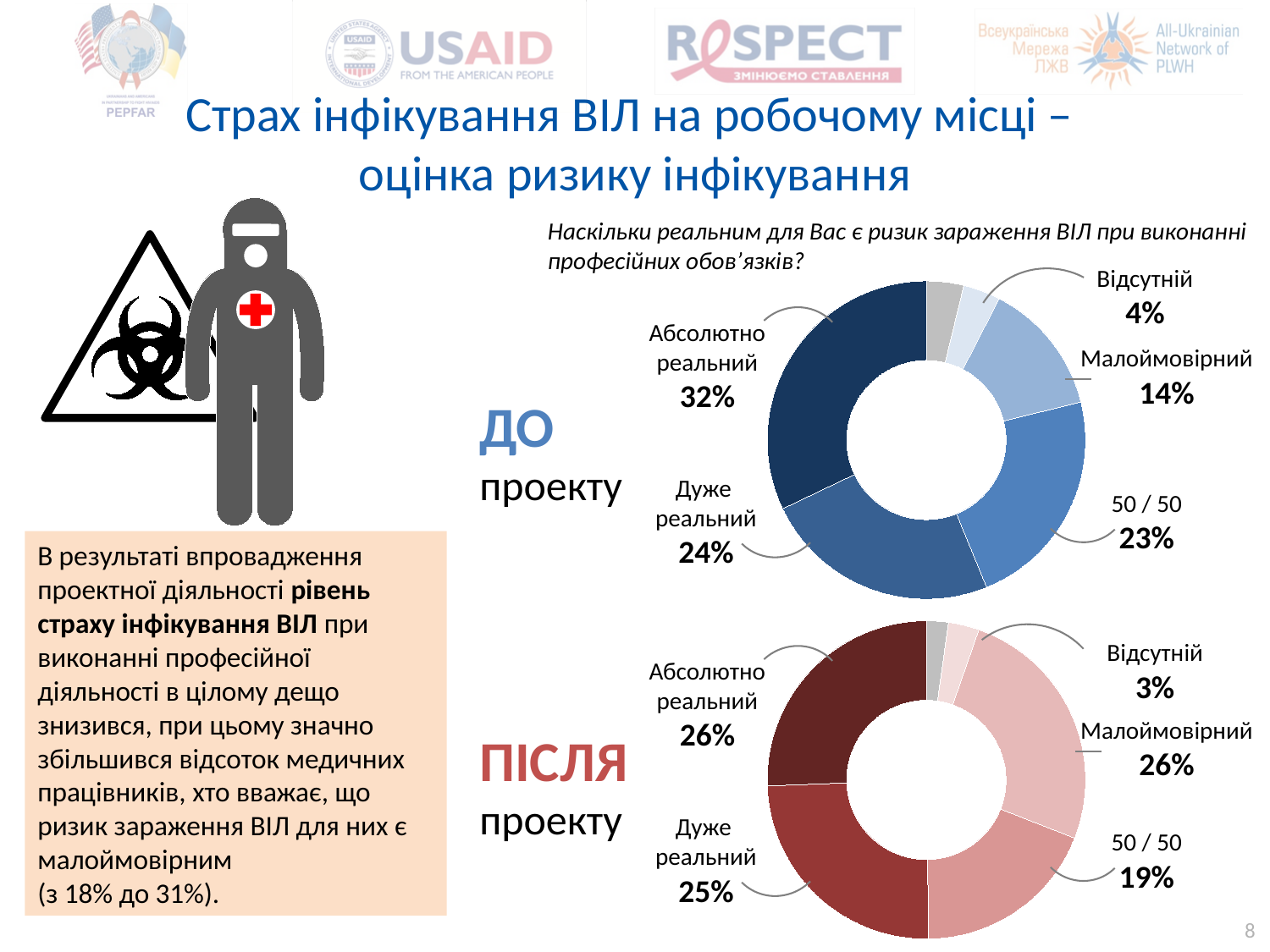
In the 'ДО проекту' chart, which labelled category has the smallest share? Відсутній In the 'ПІСЛЯ проекту' chart, which labelled category has the smallest share? Відсутній In the 'ДО проекту' chart, what is the difference between 'Абсолютно реальний' and 'Дуже реальний'? 8 percentage points In the 'ДО проекту' chart, what percentage is shown for 'Малоймовірний'? 14% What is the difference between the 'Малоймовірний' share in the 'ПІСЛЯ проекту' chart and in the 'ДО проекту' chart? 12 percentage points In the 'ДО проекту' chart, which labelled category has the largest share? Абсолютно реальний Is the 'Абсолютно реальний' share larger in the 'ДО проекту' chart or in the 'ПІСЛЯ проекту' chart? ДО проекту What type of chart is used for the 'ДО проекту' and 'ПІСЛЯ проекту' data? Donut (pie) chart In the 'ПІСЛЯ проекту' chart, what percentage is shown for '50 / 50'? 19% In the 'ДО проекту' chart, what percentage is shown for 'Абсолютно реальний'? 32% In the 'ДО проекту' chart, which is larger: '50 / 50' or 'Малоймовірний'? 50 / 50 In the 'ПІСЛЯ проекту' chart, what percentage is shown for 'Відсутній'? 3%